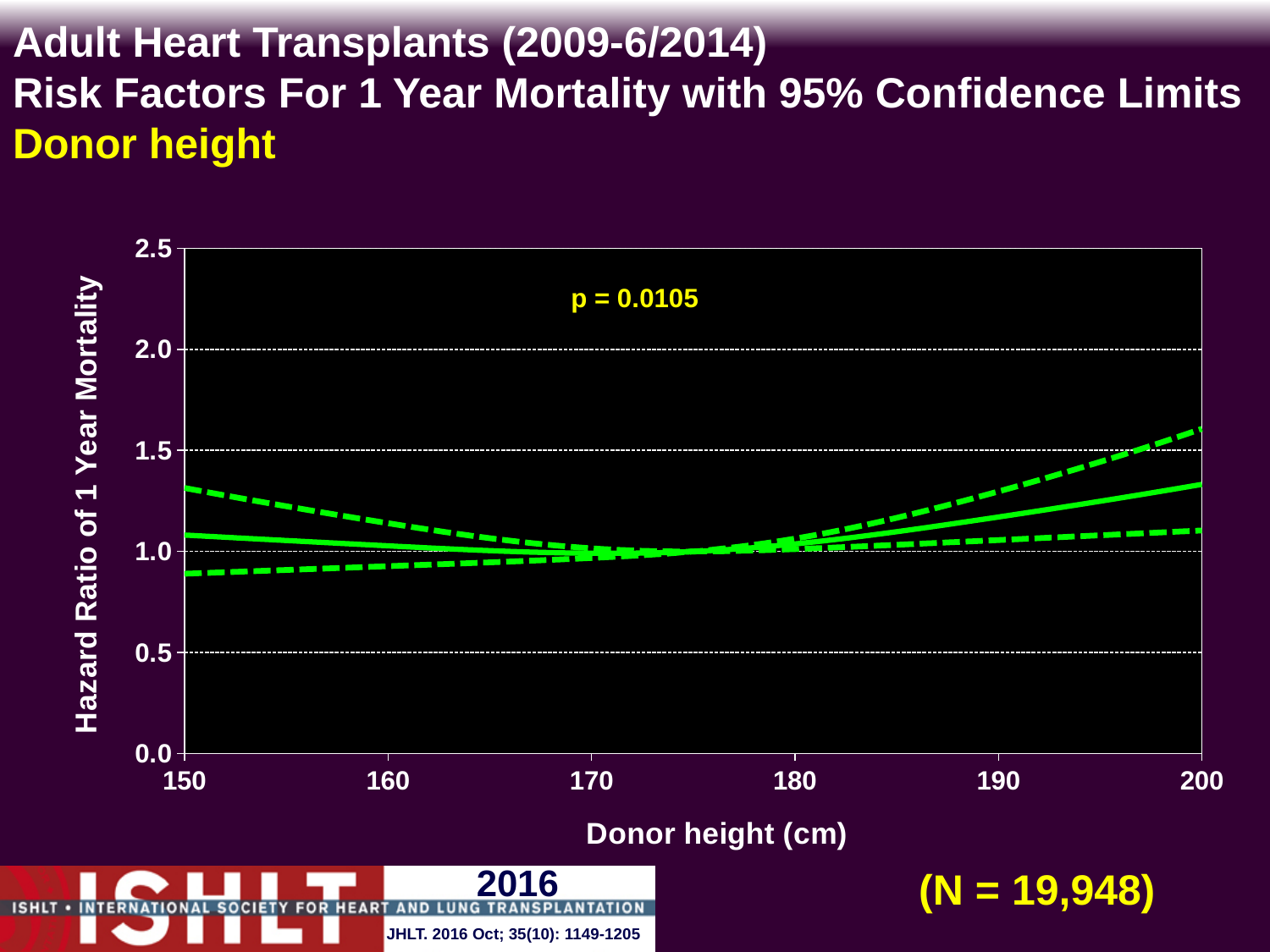
What kind of chart is shown on the slide? line chart What is the highest value shown on the y-axis of the chart? 2.5 How many lines are plotted on the chart? 3 Is the upper 95% confidence limit (upper dashed line) at a donor height of 200 cm greater or less than 2.0? less What p-value is printed on the chart? p = 0.0105 Is the upper 95% confidence limit (upper dashed line) at a donor height of 150 cm greater or less than 1.0? greater Is the hazard ratio (solid line) higher at a donor height of 200 cm or at 175 cm? 200 cm Is the hazard ratio (solid line) at a donor height of 200 cm greater or less than 1.0? greater Does the hazard ratio (solid line) rise or fall as donor height increases from 180 cm to 200 cm? rise What sample size (N) is shown on the slide? N = 19,948